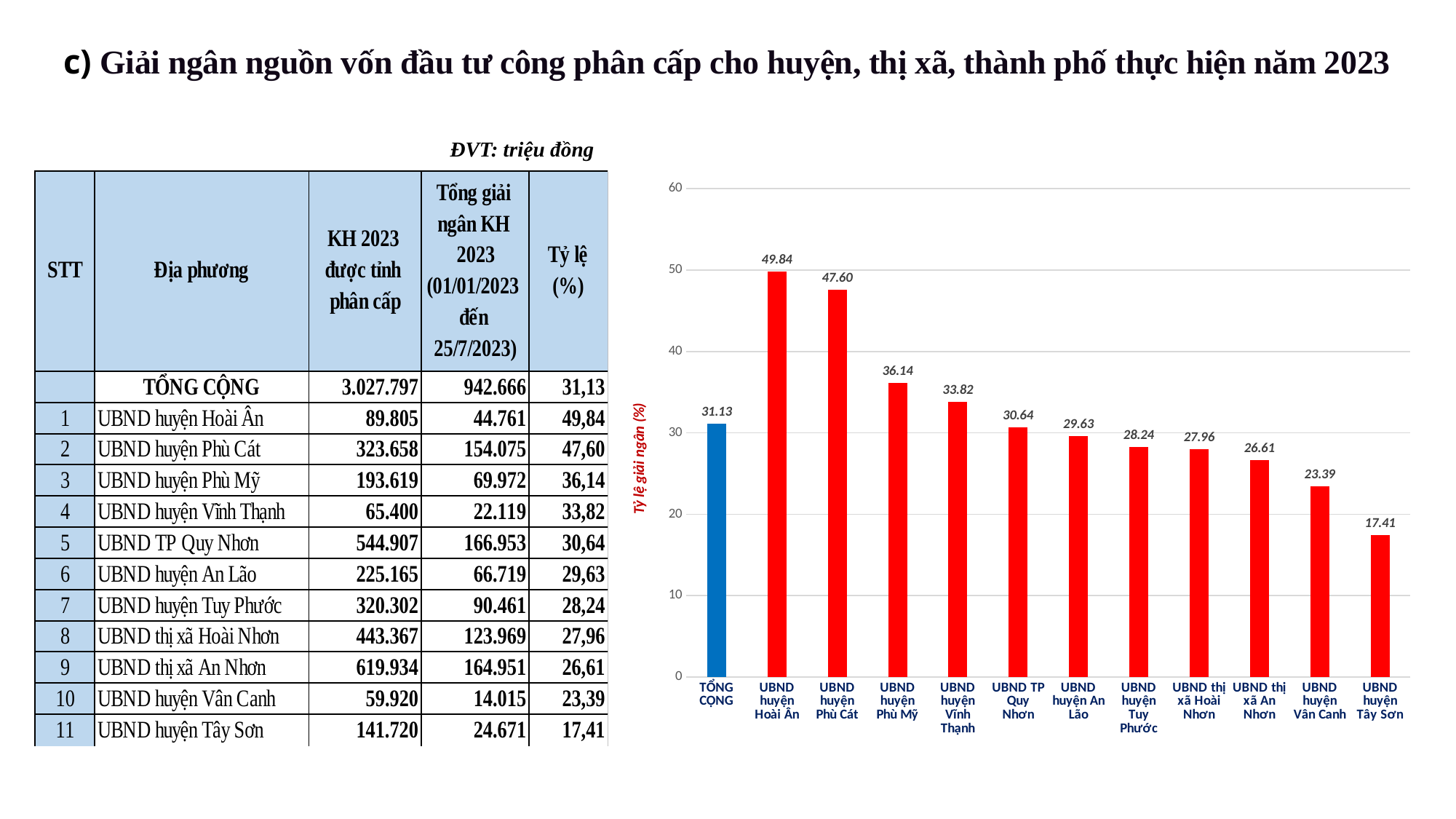
What is the value shown for UBND huyện Tây Sơn in the chart? 17.41 Which category has the highest value in the chart? UBND huyện Hoài Ân Do the values of the red bars rise or fall from left to right along the x axis? Fall How many bars are plotted in the chart? 12 What is the value shown for UBND huyện Hoài Ân in the chart? 49.84 Which is larger in the chart: the value for UBND TP Quy Nhơn or the value for UBND huyện Vân Canh? UBND TP Quy Nhơn What is the difference between the values for UBND huyện Hoài Ân and UBND huyện Phù Cát? 2.24 What is the value shown for TỔNG CỘNG in the chart? 31.13 Is the value for UBND huyện Phù Mỹ greater or less than 40? less What is the label on the vertical axis of the chart? Tỷ lệ giải ngân (%) Which category has the lowest value in the chart? UBND huyện Tây Sơn What kind of chart is shown on the slide? Bar chart